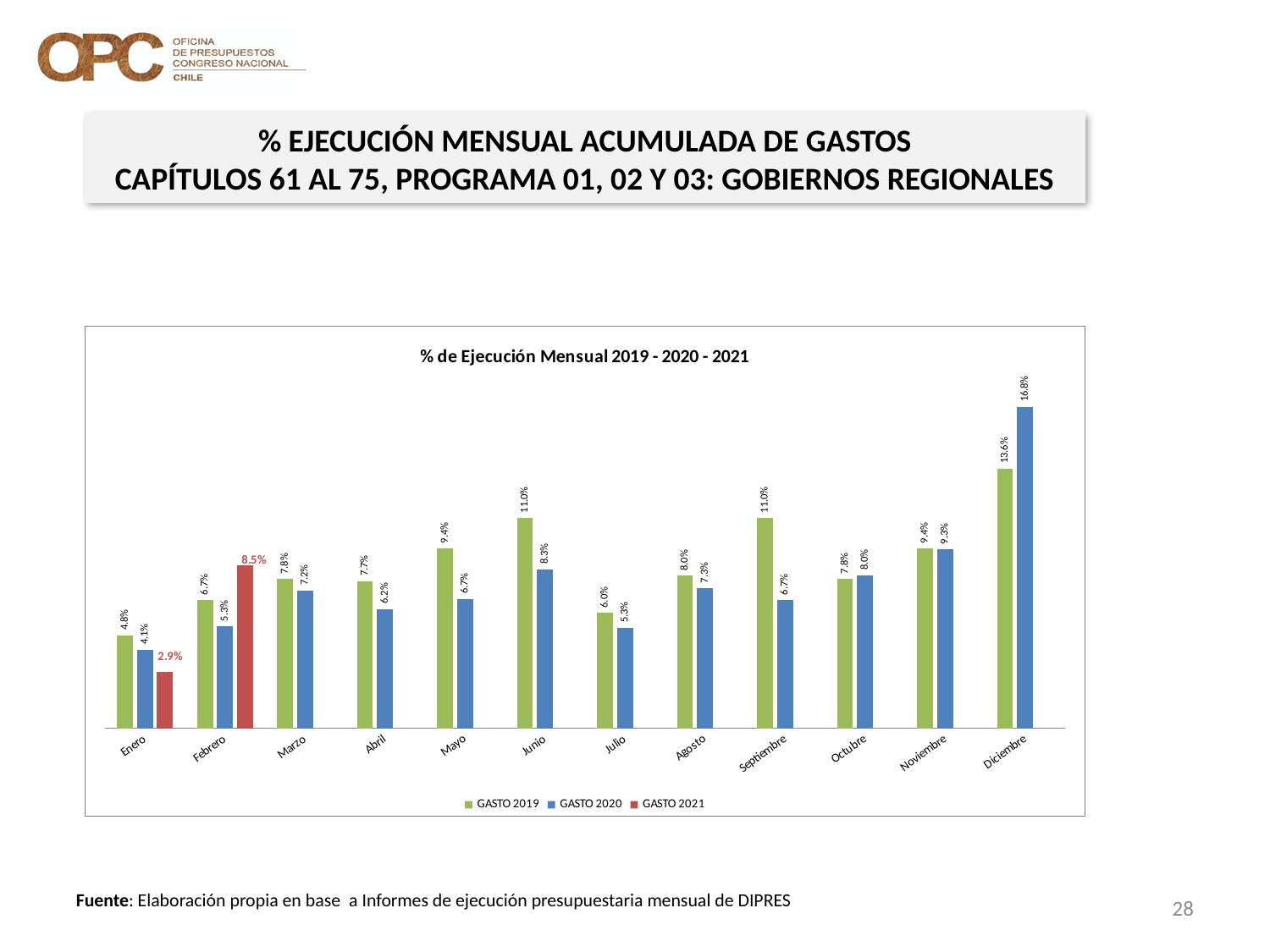
What kind of chart is shown on the slide? Bar chart How many series does the legend list? 3 Which month has the lowest value for GASTO 2019? Enero How many months are shown on the x axis? 12 What is the difference between GASTO 2019 and GASTO 2020 in Septiembre? 4.3% What is the value for GASTO 2020 in Diciembre? 16.8% What is the value for GASTO 2019 in Junio? 11.0% What is the value for GASTO 2021 in Enero? 2.9% What is the value for GASTO 2021 in Febrero? 8.5% Which is larger in Diciembre, GASTO 2019 or GASTO 2020? GASTO 2020 What colour represents GASTO 2021 in the chart? Red Which month has the highest value for GASTO 2020? Diciembre